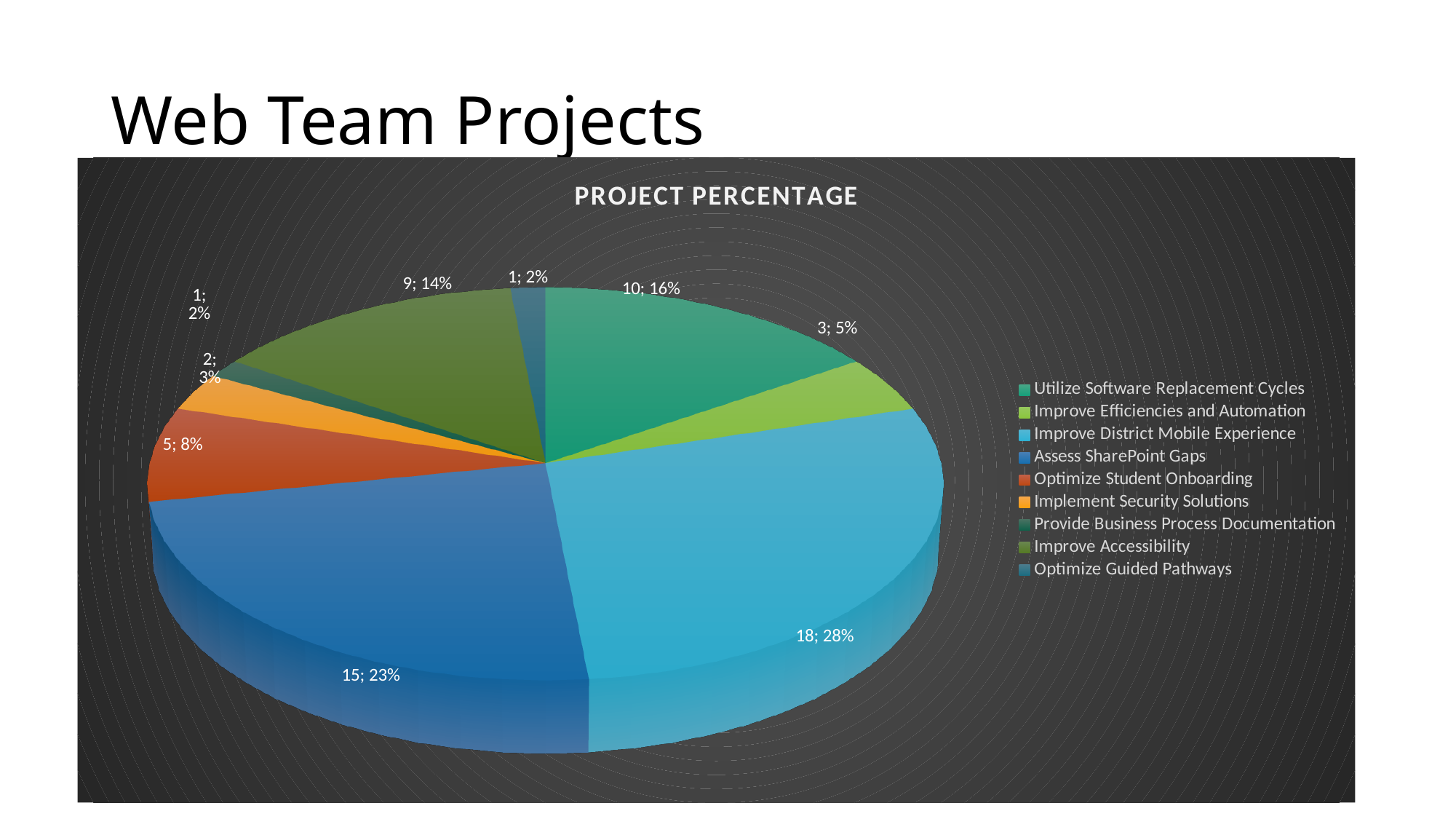
Which category has the largest share of the pie? Improve District Mobile Experience What is the title of the chart? PROJECT PERCENTAGE What percentage share does Implement Security Solutions have? 3% How many categories does the pie chart have? 9 Which is larger, the value for Optimize Student Onboarding or the value for Improve Efficiencies and Automation? Optimize Student Onboarding What is the value for Optimize Guided Pathways? 1 What type of chart is shown on the slide? pie chart What percentage share does Improve District Mobile Experience have? 28% What is the difference between the values for Improve District Mobile Experience and Assess SharePoint Gaps? 3 What is the value for Assess SharePoint Gaps? 15 What percentage share does Utilize Software Replacement Cycles have? 16% What is the value for Improve Accessibility? 9